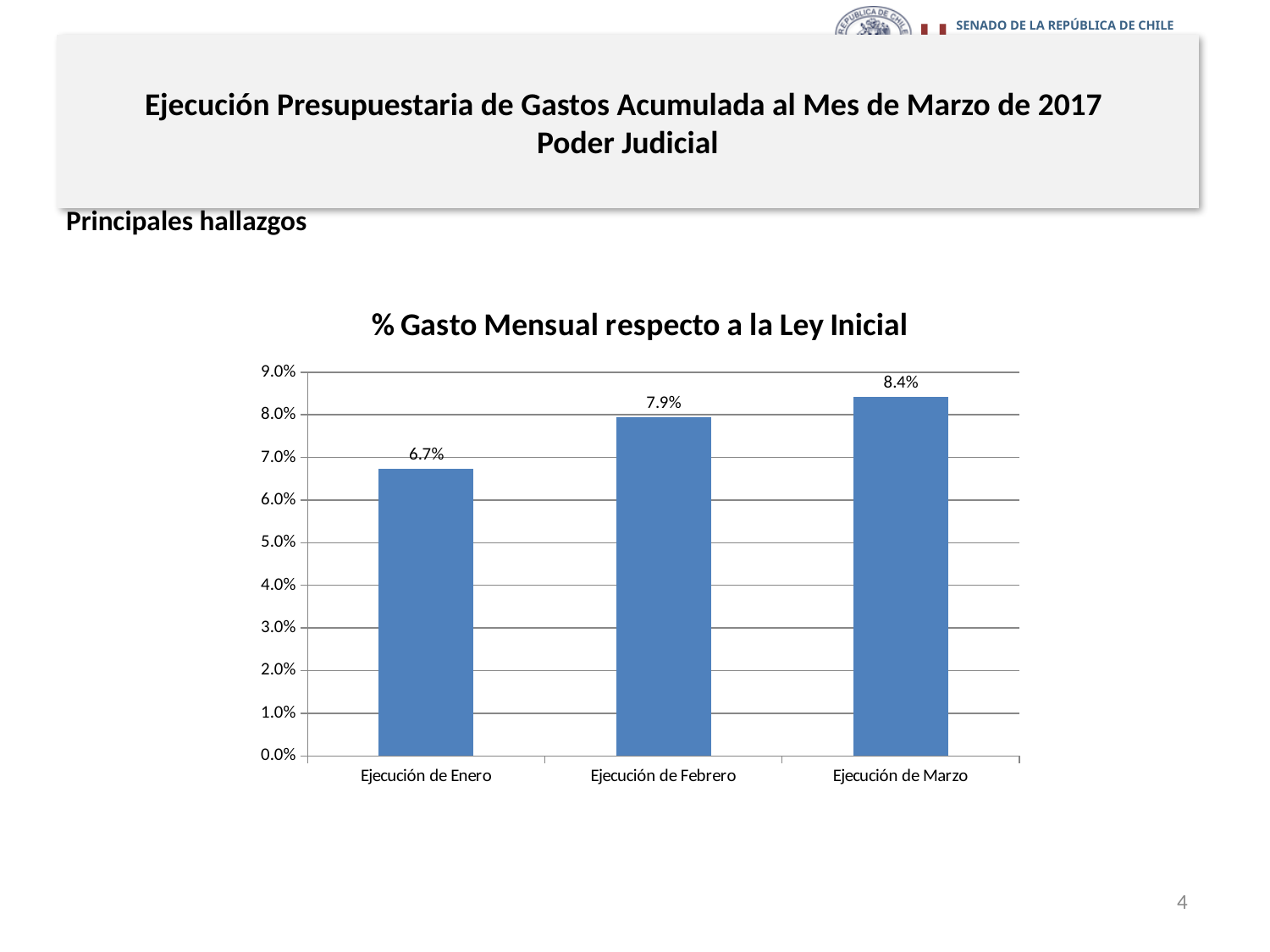
What kind of chart is shown on the slide? Bar chart Which is larger, the value for Ejecución de Febrero or Ejecución de Marzo? Ejecución de Marzo What is the difference between the values for Ejecución de Febrero and Ejecución de Enero? 1.2% Which category has the lowest value? Ejecución de Enero What is the value for Ejecución de Marzo? 8.4% Is the value for Ejecución de Enero greater or less than 7.0%? less What is the value for Ejecución de Febrero? 7.9% How many categories are shown on the x axis? 3 What is the difference between the values for Ejecución de Marzo and Ejecución de Enero? 1.7% Do the values rise or fall from Ejecución de Enero to Ejecución de Marzo? Rise What is the value for Ejecución de Enero? 6.7% Which category has the highest value? Ejecución de Marzo